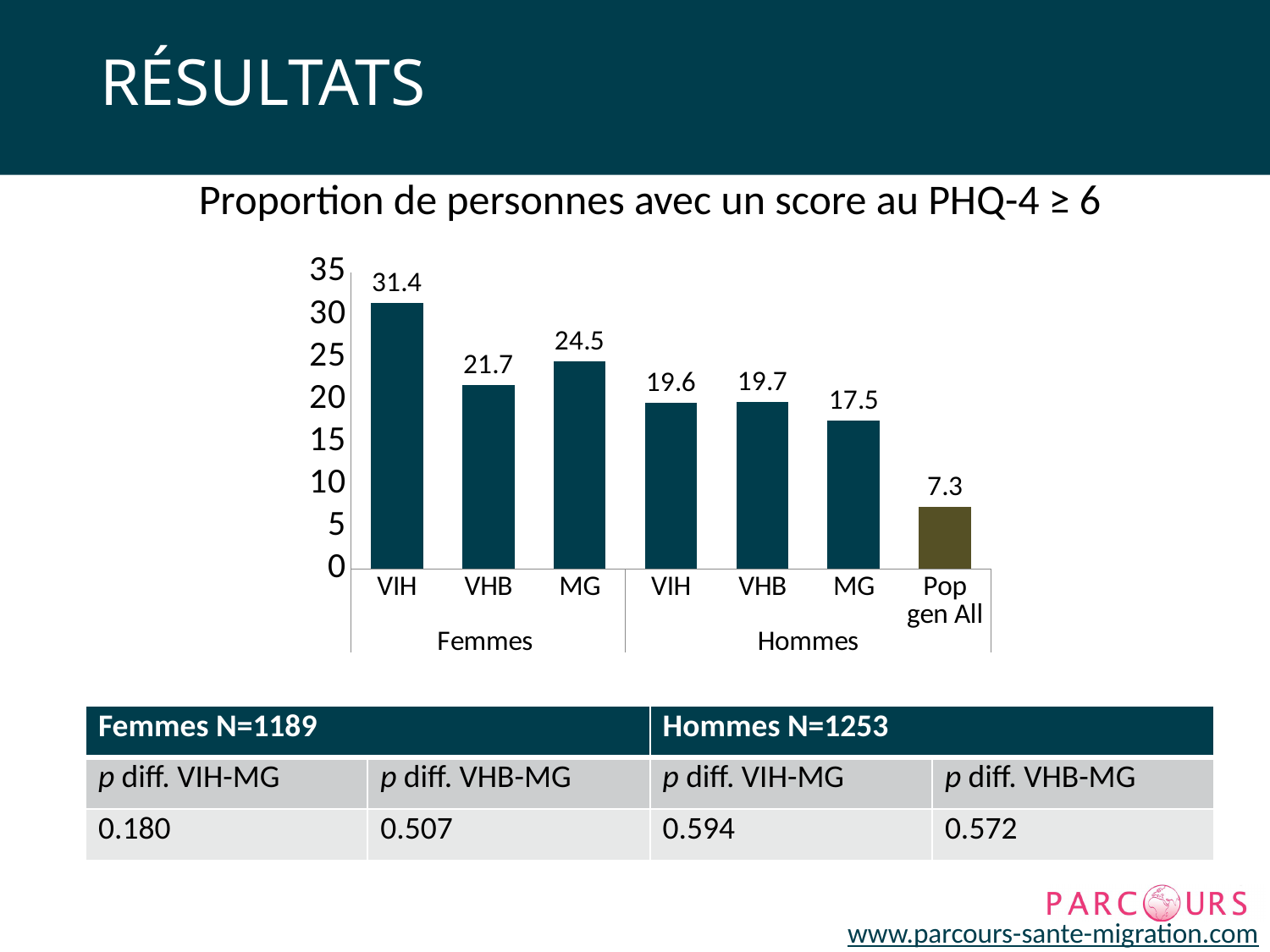
Which is larger: the MG value for Femmes or the MG value for Hommes? MG for Femmes How many bars are plotted in the chart? 7 What is the title of the chart? Proportion de personnes avec un score au PHQ-4 ≥ 6 Is the value for VHB among Femmes greater or less than 20? greater What is the difference between the VIH value for Femmes and the VIH value for Hommes? 11.8 Which bar has the lowest value? Pop gen All What kind of chart is shown? Bar chart Which bar has the highest value? VIH (Femmes) What is the value for VIH among Femmes? 31.4 What is the value for MG among Hommes? 17.5 What is the difference between the VHB value for Hommes and the MG value for Hommes? 2.2 What is the value for Pop gen All? 7.3